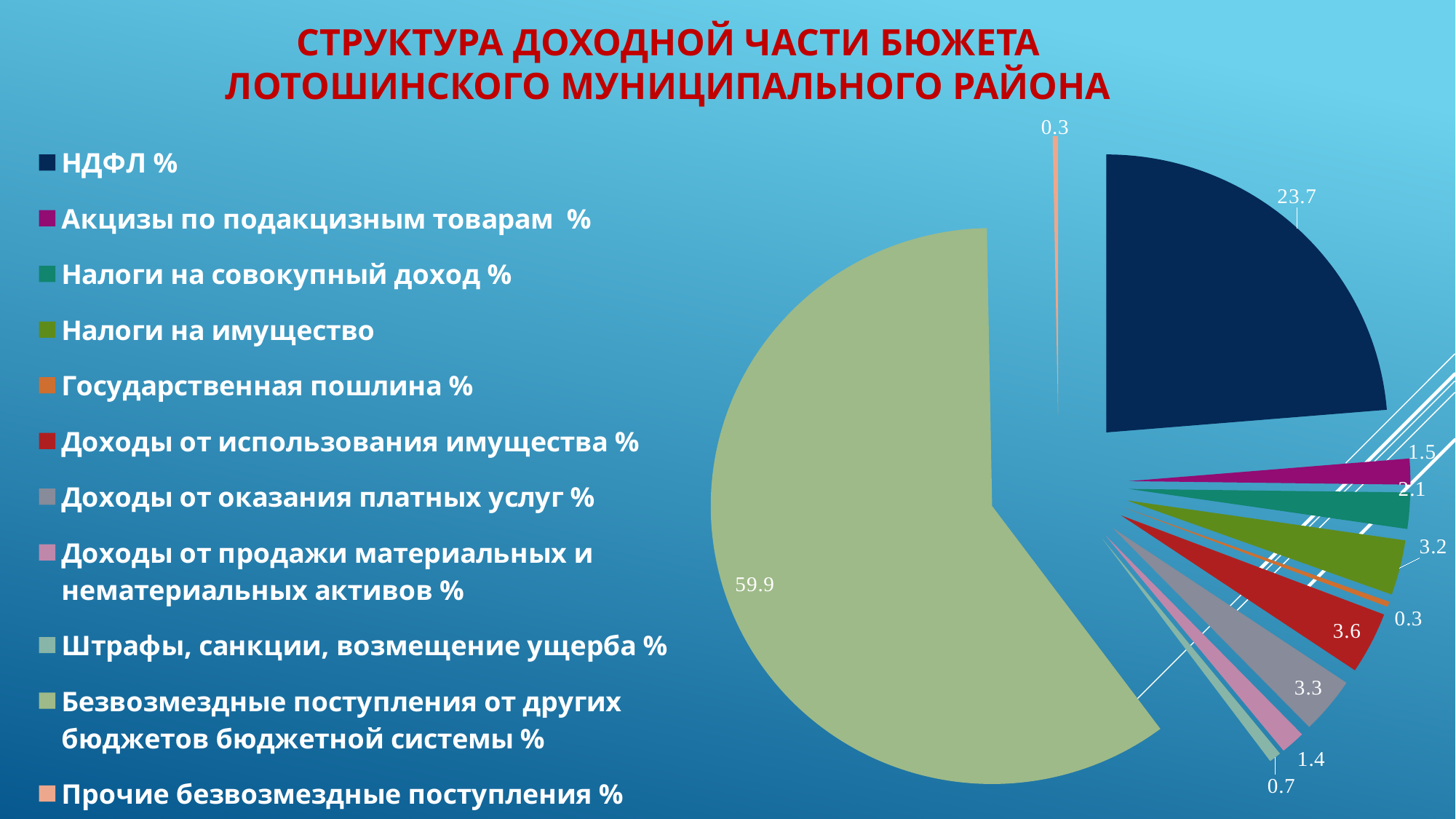
What is the difference between the values for Акцизы по подакцизным товарам % and Доходы от продажи материальных и нематериальных активов %? 0.1 What is the title of the slide containing the pie chart? Структура доходной части бюжета Лотошинского муниципального района What kind of chart is shown on the slide? pie chart What is the value shown for НДФЛ % in the pie chart? 23.7 What is the value shown for Безвозмездные поступления от других бюджетов бюджетной системы %? 59.9 Which category has the largest slice in the pie chart? Безвозмездные поступления от других бюджетов бюджетной системы % What is the value shown for Налоги на имущество? 3.2 What is the value shown for Штрафы, санкции, возмещение ущерба %? 0.7 What is the difference between the values for Безвозмездные поступления от других бюджетов бюджетной системы % and НДФЛ %? 36.2 Which is larger: Доходы от оказания платных услуг % or Налоги на совокупный доход %? Доходы от оказания платных услуг % How many categories does the legend of the pie chart list? 11 What is the value shown for Доходы от использования имущества %? 3.6